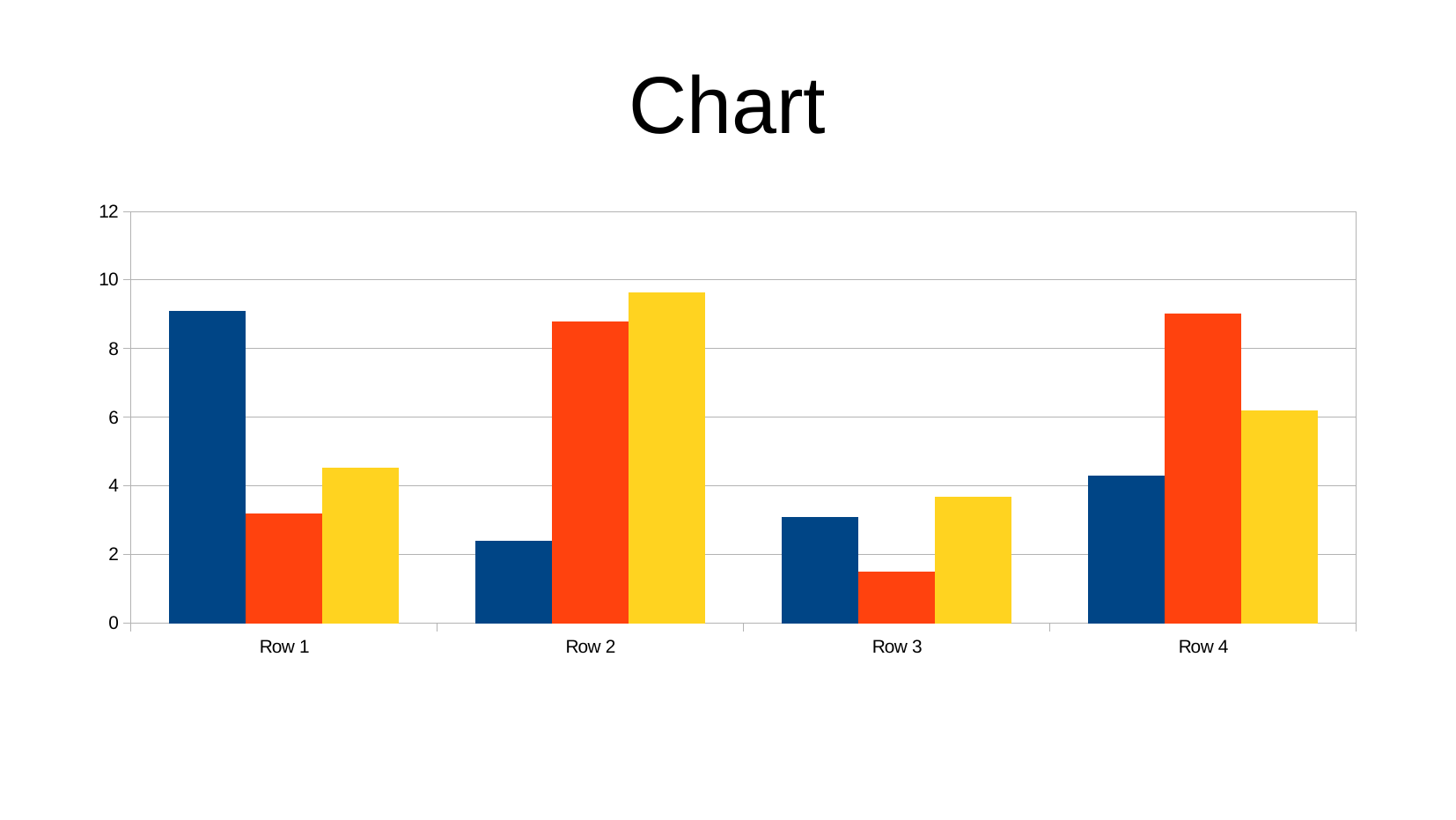
Is the value of the orange bar for Row 3 greater or less than 2? less What kind of chart is shown on the slide? bar chart Which category has the shortest orange bar? Row 3 For Row 4, which is larger, the orange bar or the yellow bar? orange bar How many bars are shown for each category? 3 Is the value of the blue bar for Row 1 greater or less than 8? greater Is the value of the yellow bar for Row 2 greater or less than 8? greater What is the highest value shown on the y axis? 12 What is the title of the chart? Chart How many categories are shown on the x axis? 4 Which category has the tallest blue bar? Row 1